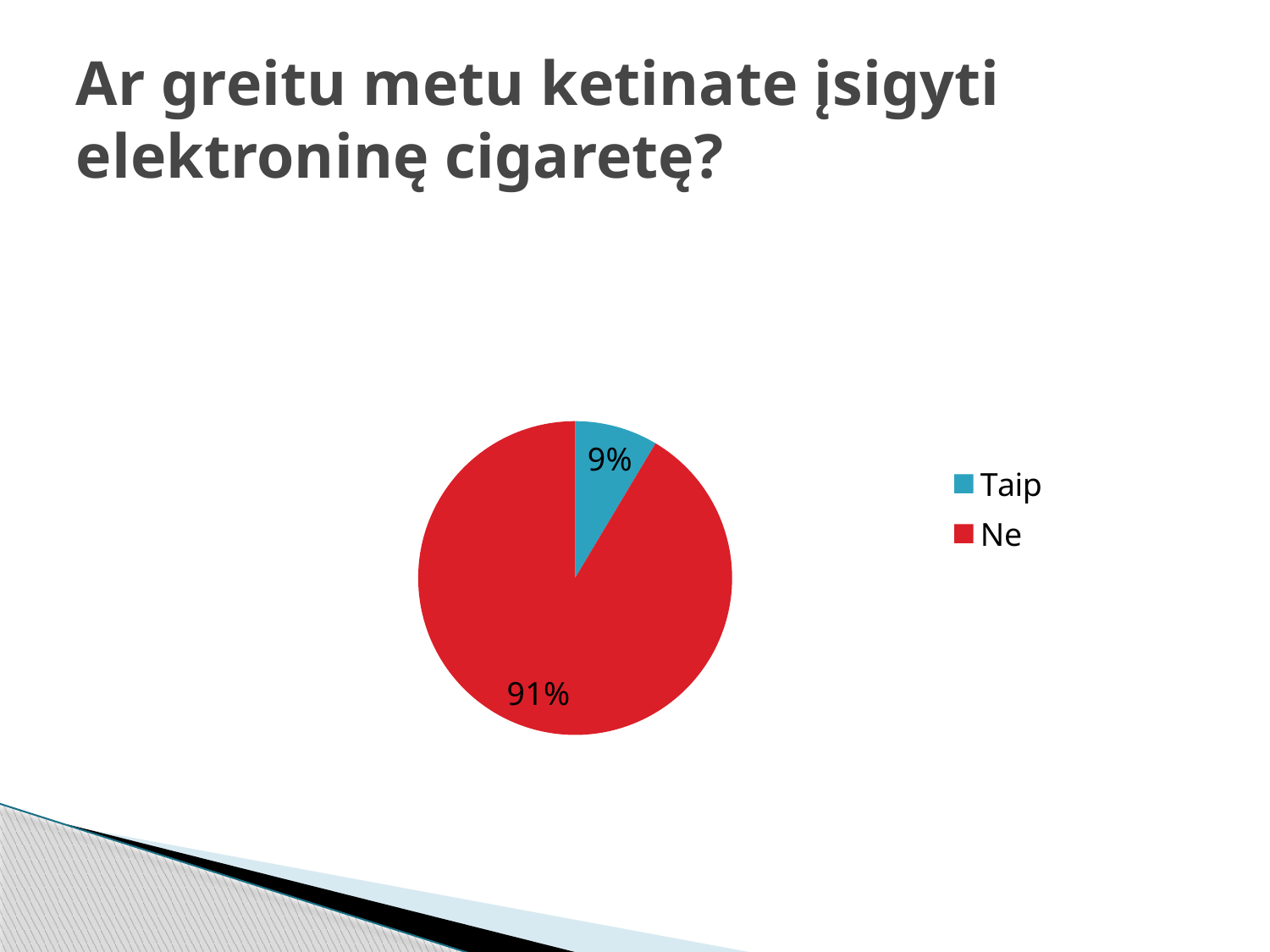
What percentage of the pie is labelled "Taip"? 9% What share of the pie does the "Taip" slice represent? 9% Which category has the smallest share of the pie? Taip Which slice is larger, "Taip" or "Ne"? Ne What is the difference in percentage points between the "Ne" and "Taip" slices? 82 What kind of chart is shown on the slide? pie chart How many entries does the legend list? 2 What colour is the "Taip" slice? blue How many slices does the pie chart have? 2 What colour is the "Ne" slice? red What percentage of the pie is labelled "Ne"? 91% Which category has the largest share of the pie? Ne